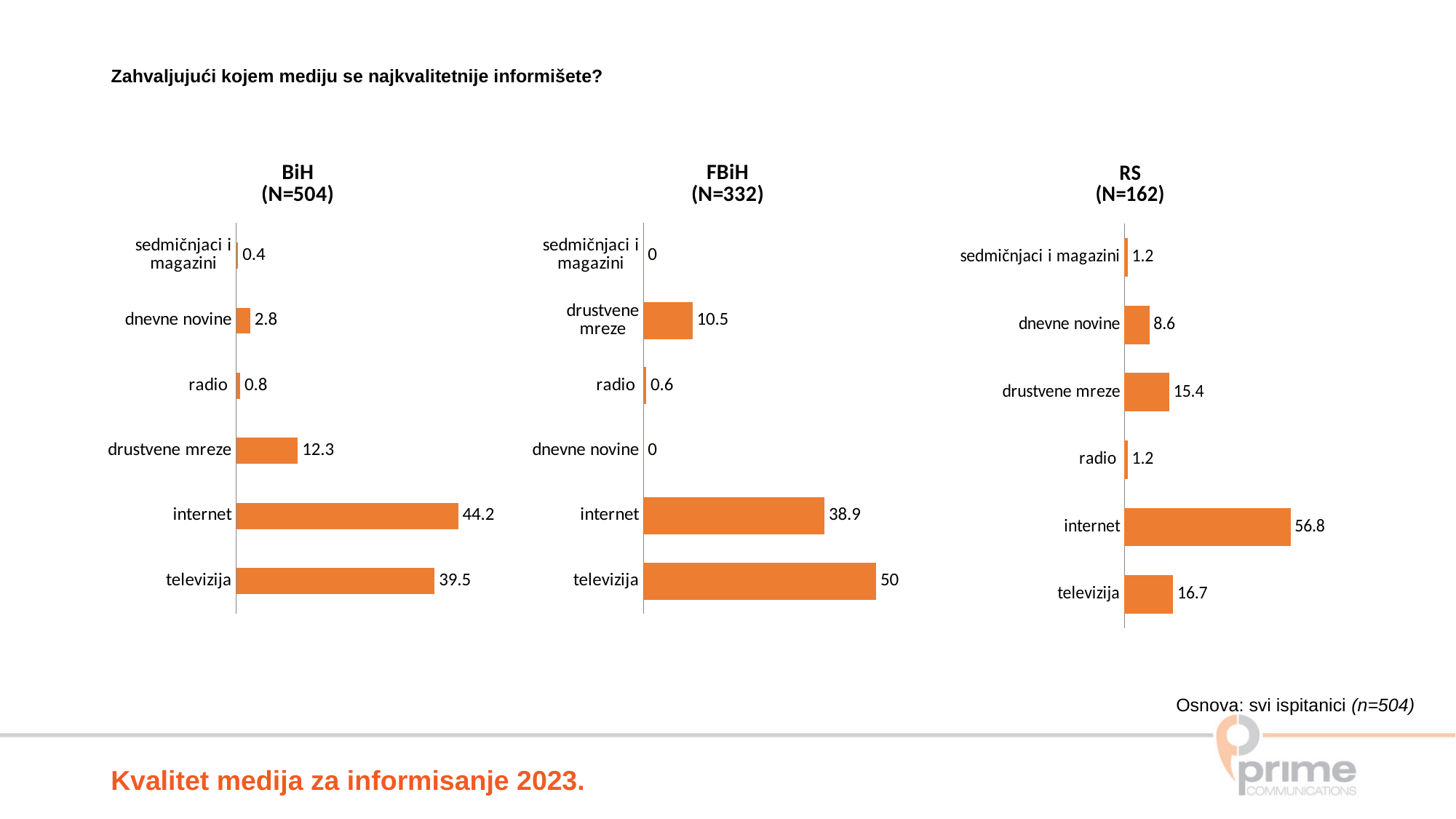
What kind of chart is the RS (N=162) chart? bar chart In the FBiH (N=332) chart, which is larger, the value for drustvene mreze or the value for radio? drustvene mreze In the RS (N=162) chart, what is the value for drustvene mreze? 15.4 How many categories does the BiH (N=504) chart show? 6 In the RS (N=162) chart, which category has the highest value? internet In the FBiH (N=332) chart, what is the value for televizija? 50 In the BiH (N=504) chart, what is the value for internet? 44.2 In the FBiH (N=332) chart, which category has the highest value? televizija In the BiH (N=504) chart, what is the difference between the values for internet and televizija? 4.7 How many charts are shown on the slide? 3 In the BiH (N=504) chart, which category has the lowest value? sedmičnjaci i magazini In the RS (N=162) chart, what is the difference between the values for internet and televizija? 40.1